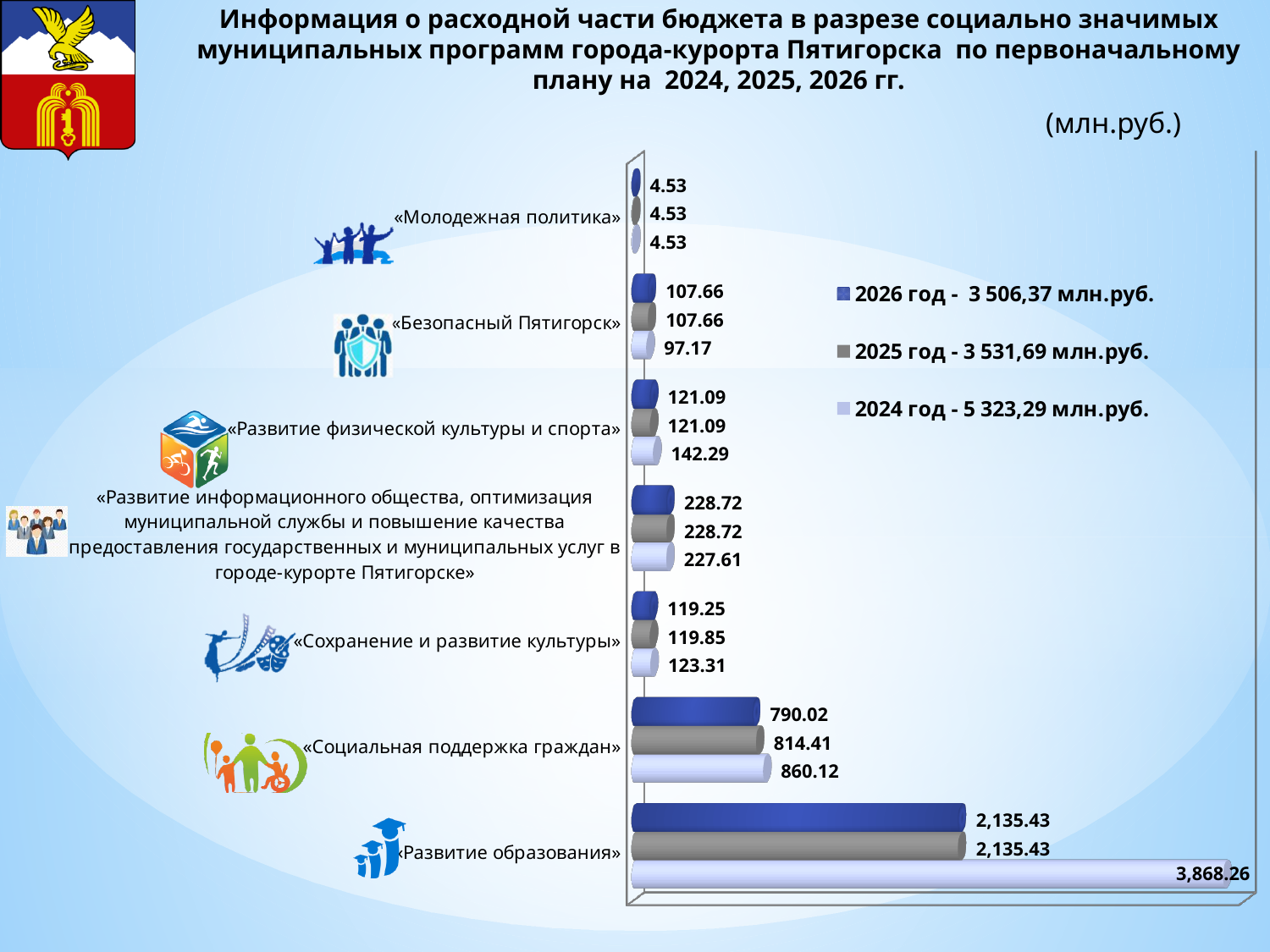
How many categories (programmes) are shown on the chart? 7 Which category has the lowest value in the 2024 год series? «Молодежная политика» What is the value for «Развитие образования» in the 2024 год series? 3,868.26 What is the difference between the 2024 год and 2026 год values for «Социальная поддержка граждан»? 70.10 What is the value for «Социальная поддержка граждан» in the 2025 год series? 814.41 Which is larger for «Развитие физической культуры и спорта»: the 2024 год value or the 2026 год value? 2024 год What is the value for «Сохранение и развитие культуры» in the 2026 год series? 119.25 What is the value for «Безопасный Пятигорск» in the 2024 год series? 97.17 Which category has the highest value in the 2026 год series? «Развитие образования» How many series does the legend list? 3 According to the legend, what is the total for 2025 год? 3 531,69 млн.руб. What kind of chart is shown on the slide? Bar chart